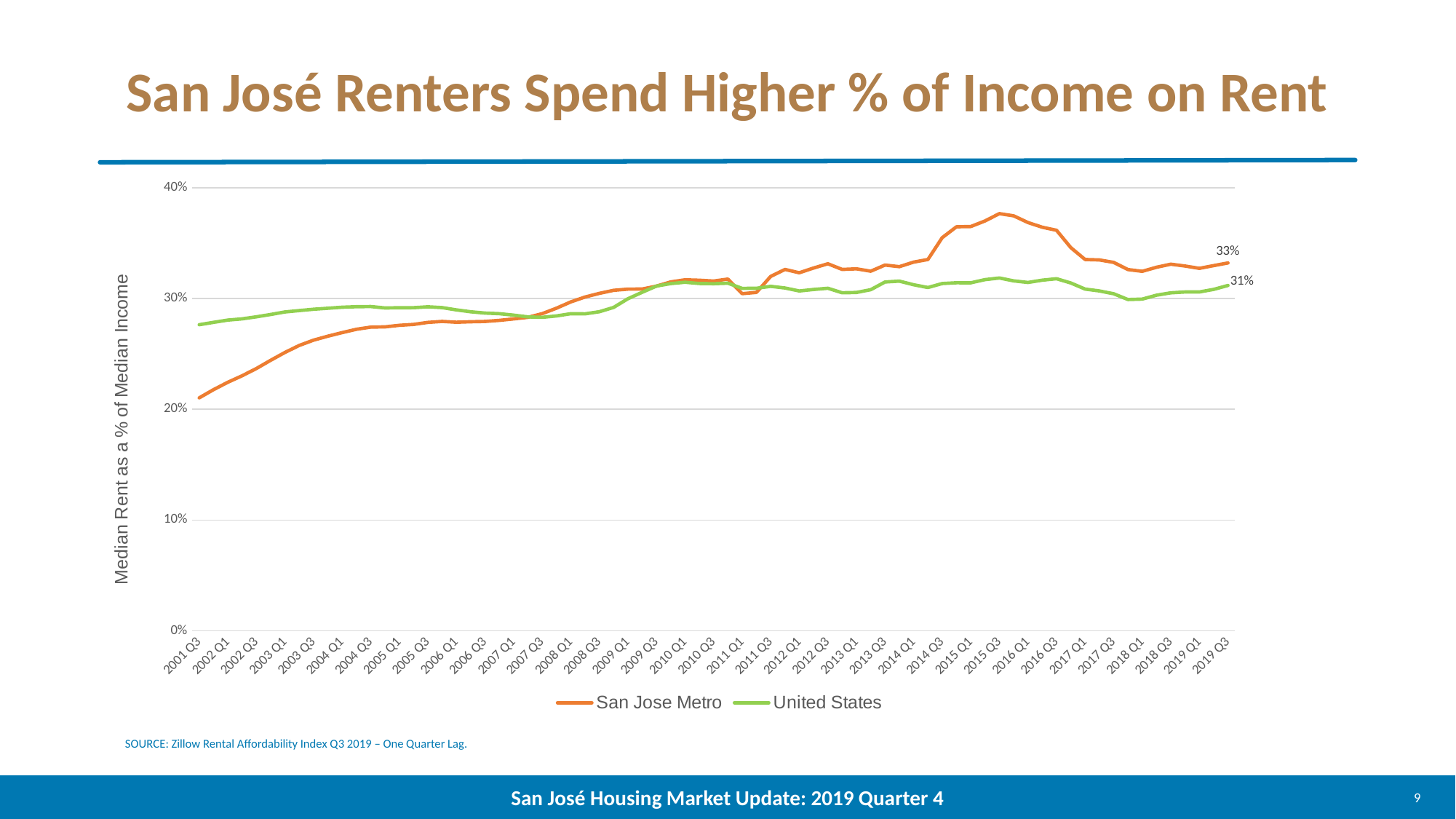
What is the label on the vertical axis of the chart? Median Rent as a % of Median Income Is the value for United States at 2001 Q3 greater or less than 25%? greater Is the value for San Jose Metro at 2001 Q3 greater or less than 25%? less At 2019 Q3, which series has the higher value, San Jose Metro or United States? San Jose Metro What kind of chart is shown on the slide? Line chart Is the value for San Jose Metro at 2015 Q3 greater or less than 35%? greater What is the value for United States at 2019 Q3? 31% How many series does the legend list? 2 What is the value for San Jose Metro at 2019 Q3? 33% Does the San Jose Metro line rise or fall overall from 2001 Q3 to 2019 Q3? Rises What is the difference between the San Jose Metro and United States values at 2019 Q3? 2% At 2001 Q3, which series has the higher value, San Jose Metro or United States? United States